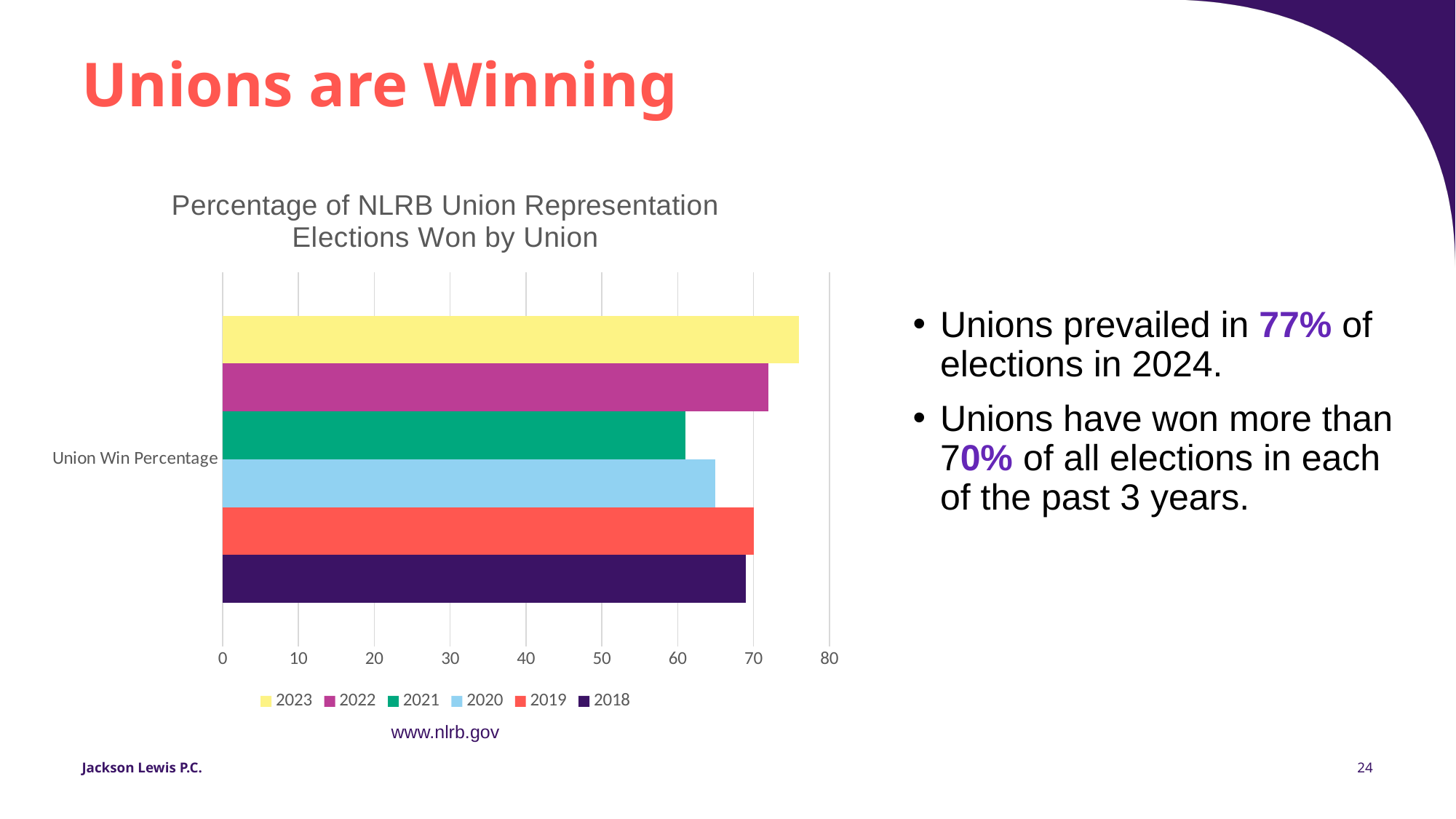
Is the union win percentage for 2023 greater or less than 70? greater Is the union win percentage for 2023 greater or less than 80? less Which year has a higher union win percentage, 2023 or 2021? 2023 Is the union win percentage for 2020 greater or less than 70? less How many series does the chart's legend list? 6 What kind of chart is shown on the slide? bar chart What is the title of the chart? Percentage of NLRB Union Representation Elections Won by Union Which year has the lowest union win percentage in the chart? 2021 How many categories are shown on the vertical axis of the chart? 1 Which colour represents 2018 in the chart's legend? dark purple Which year has the highest union win percentage in the chart? 2023